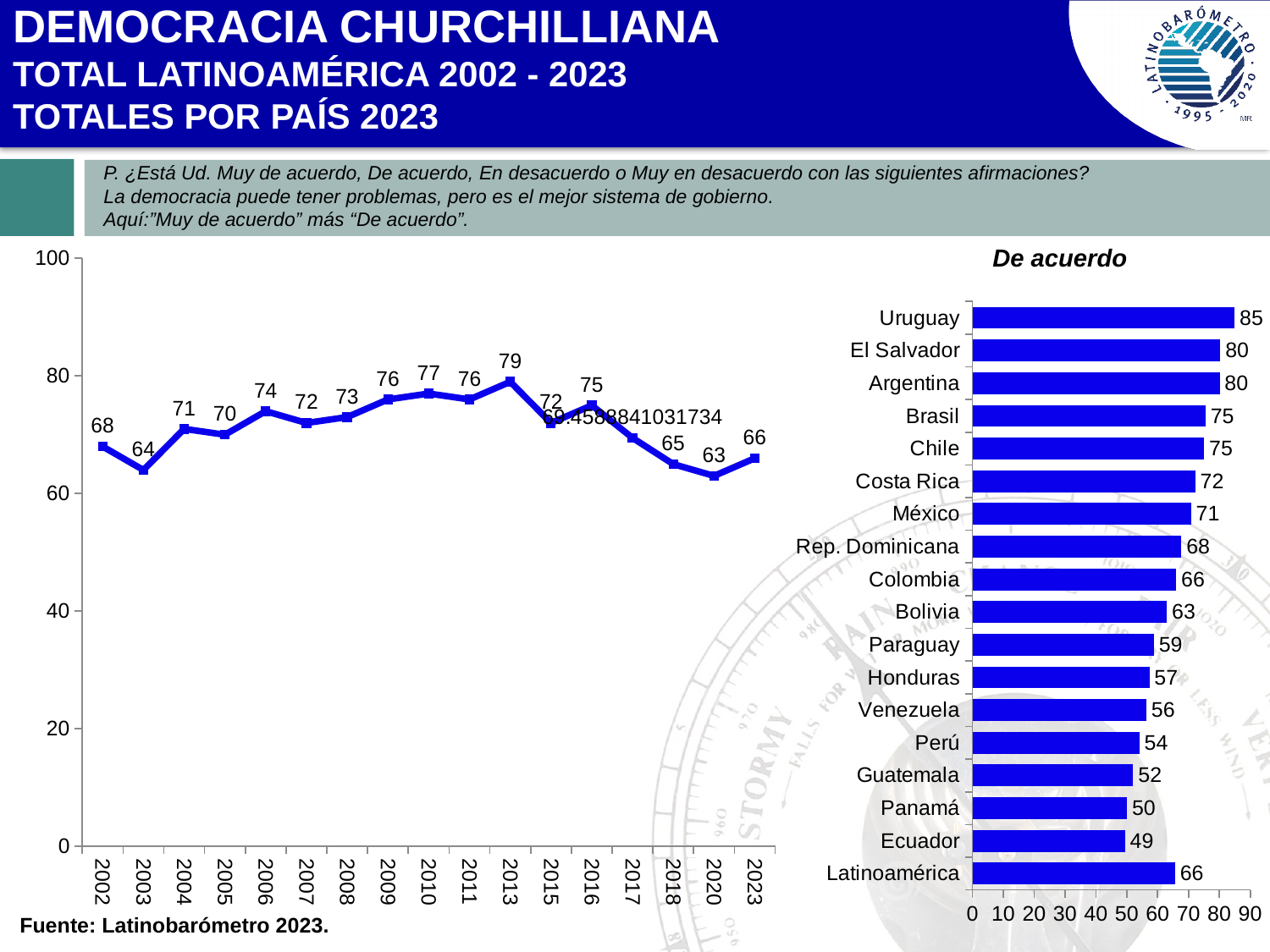
In the bar chart on the right (De acuerdo), which is larger, the value for Costa Rica or the value for Paraguay? Costa Rica In the line chart on the left, what is the value for 2013? 79 In the line chart on the left, do the values rise or fall from 2016 to 2020? Fall How many bars are shown in the bar chart on the right (De acuerdo)? 18 In the bar chart on the right (De acuerdo), what is the difference between Uruguay and Ecuador? 36 In the bar chart on the right (De acuerdo), what is the value for Latinoamérica? 66 In the bar chart on the right (De acuerdo), which country has the highest value? Uruguay In the line chart on the left, which year has the lowest value? 2020 What kind of chart is the chart on the left showing Total Latinoamérica 2002-2023? Line chart In the bar chart on the right (De acuerdo), what is the value for Uruguay? 85 In the bar chart on the right (De acuerdo), which country has the lowest value? Ecuador In the line chart on the left, what is the difference between the values for 2002 and 2023? 2